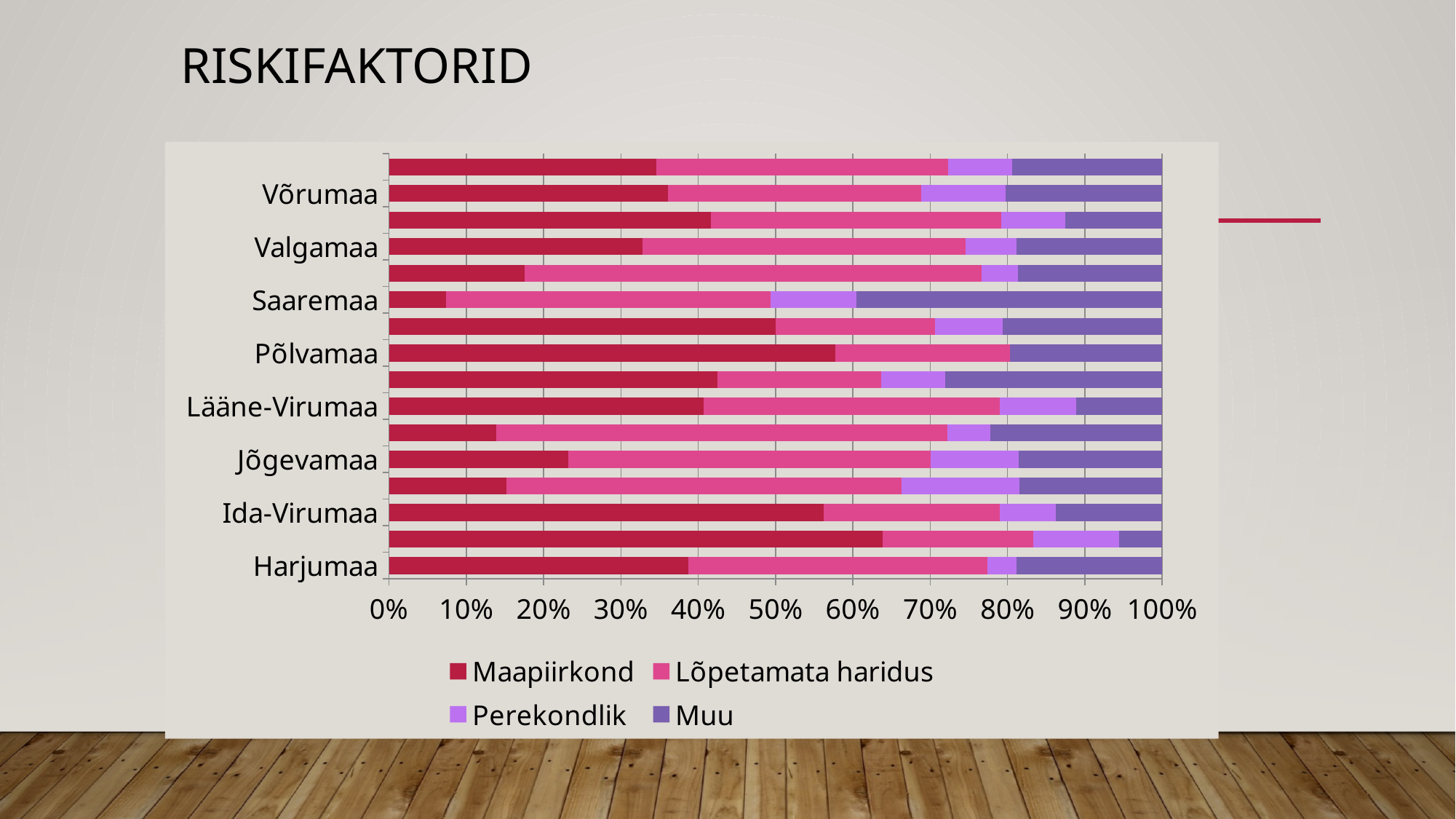
Is the Maapiirkond share for Ida-Virumaa greater or less than 50%? greater Which has the larger Muu share, Saaremaa or Harjumaa? Saaremaa Is the Maapiirkond share for Harjumaa greater or less than 30%? greater Which has the larger Maapiirkond share, Saaremaa or Ida-Virumaa? Ida-Virumaa How many series does the legend list? 4 Is the Maapiirkond share for Võrumaa greater or less than 40%? less Which series is shown in the dark red colour at the left end of each bar? Maapiirkond What is the title of the slide containing the chart? Riskifaktorid What kind of chart is shown on the slide? bar chart